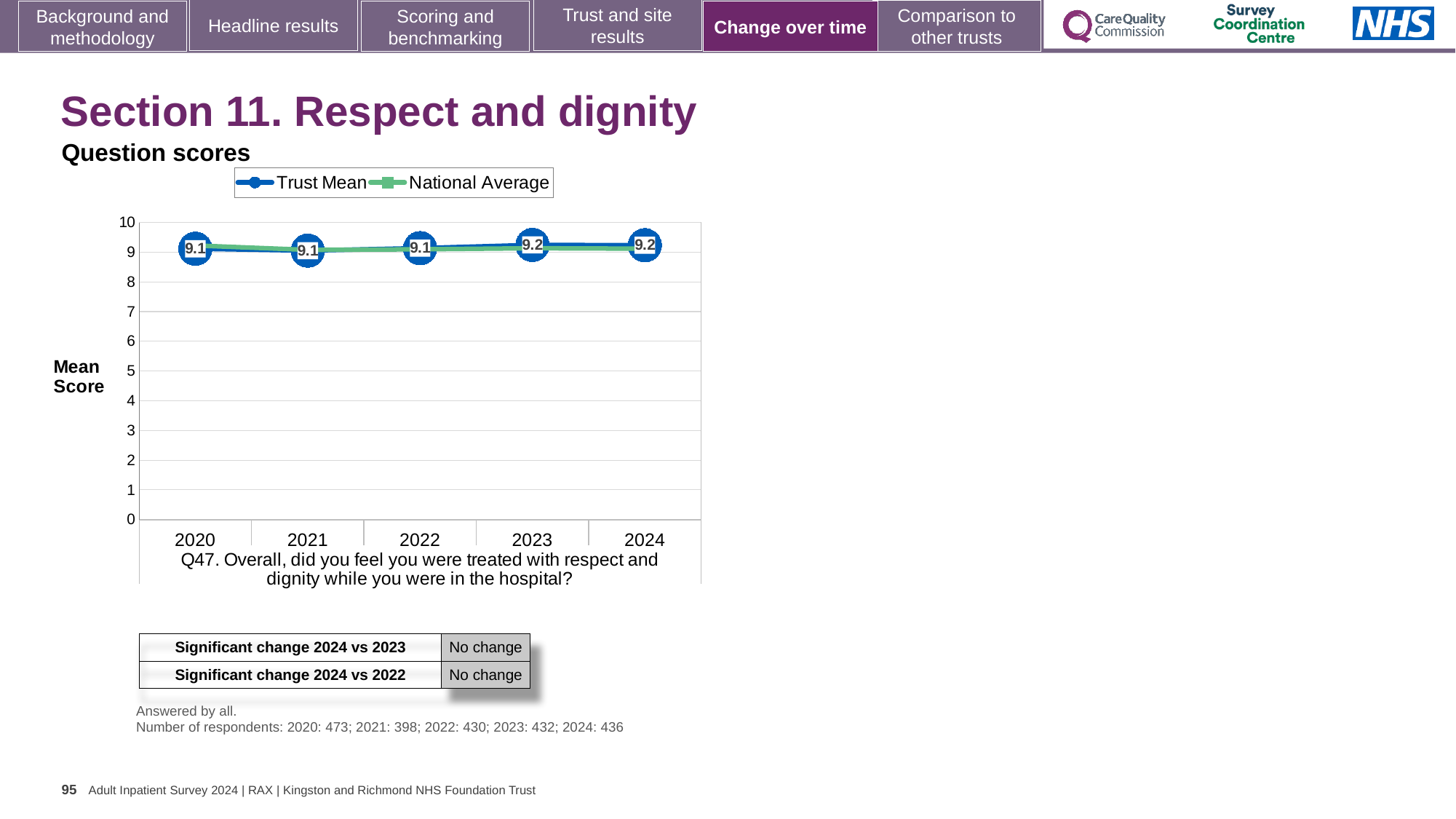
Is the National Average for 2024 greater or less than 8? greater Does the Trust Mean rise or fall from 2022 to 2024? rise What is the label of the y axis? Mean Score What is the Trust Mean for 2022? 9.1 Is the Trust Mean for 2021 greater or less than 8? greater What is the Trust Mean for 2024? 9.2 What kind of chart is shown? line chart What is the Trust Mean for 2023? 9.2 How many years are shown on the x axis? 5 How many series does the legend list? 2 What is the difference between the Trust Mean in 2024 and the Trust Mean in 2021? 0.1 What is the Trust Mean for 2020? 9.1